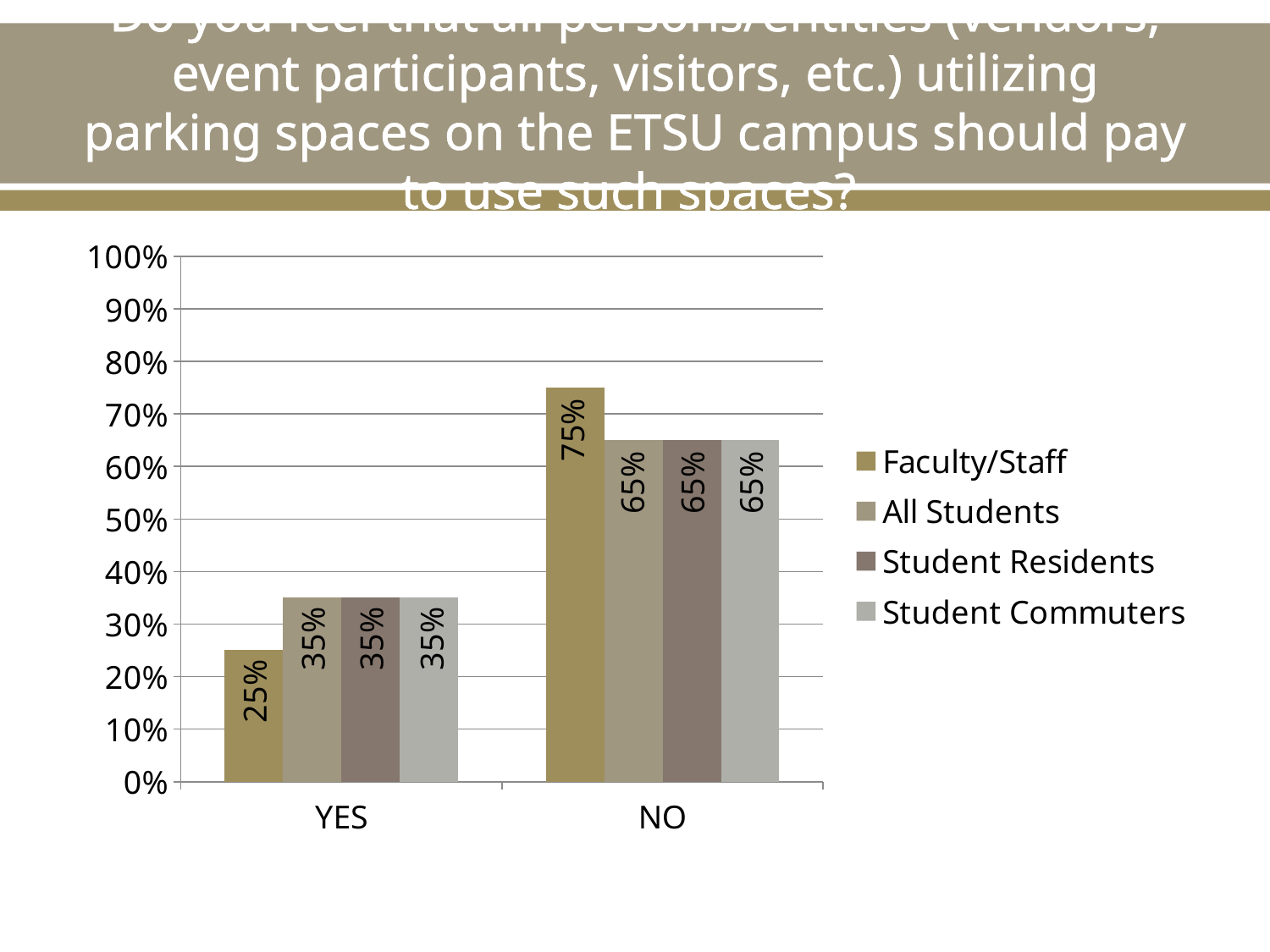
Which group has the highest value for NO? Faculty/Staff How many series does the legend list? 4 Which group has the lowest value for YES? Faculty/Staff What percentage of All Students answered YES? 35% How many categories are shown on the x axis? 2 What is the difference between the Faculty/Staff NO value and the All Students NO value? 10% What percentage of Student Residents answered NO? 65% What percentage of Student Commuters answered NO? 65% Which is larger: the Faculty/Staff YES value or the Student Residents YES value? Student Residents YES value What percentage of Faculty/Staff answered YES? 25% What is the difference between the Faculty/Staff NO value and the Faculty/Staff YES value? 50% What kind of chart is shown on the slide? Bar chart